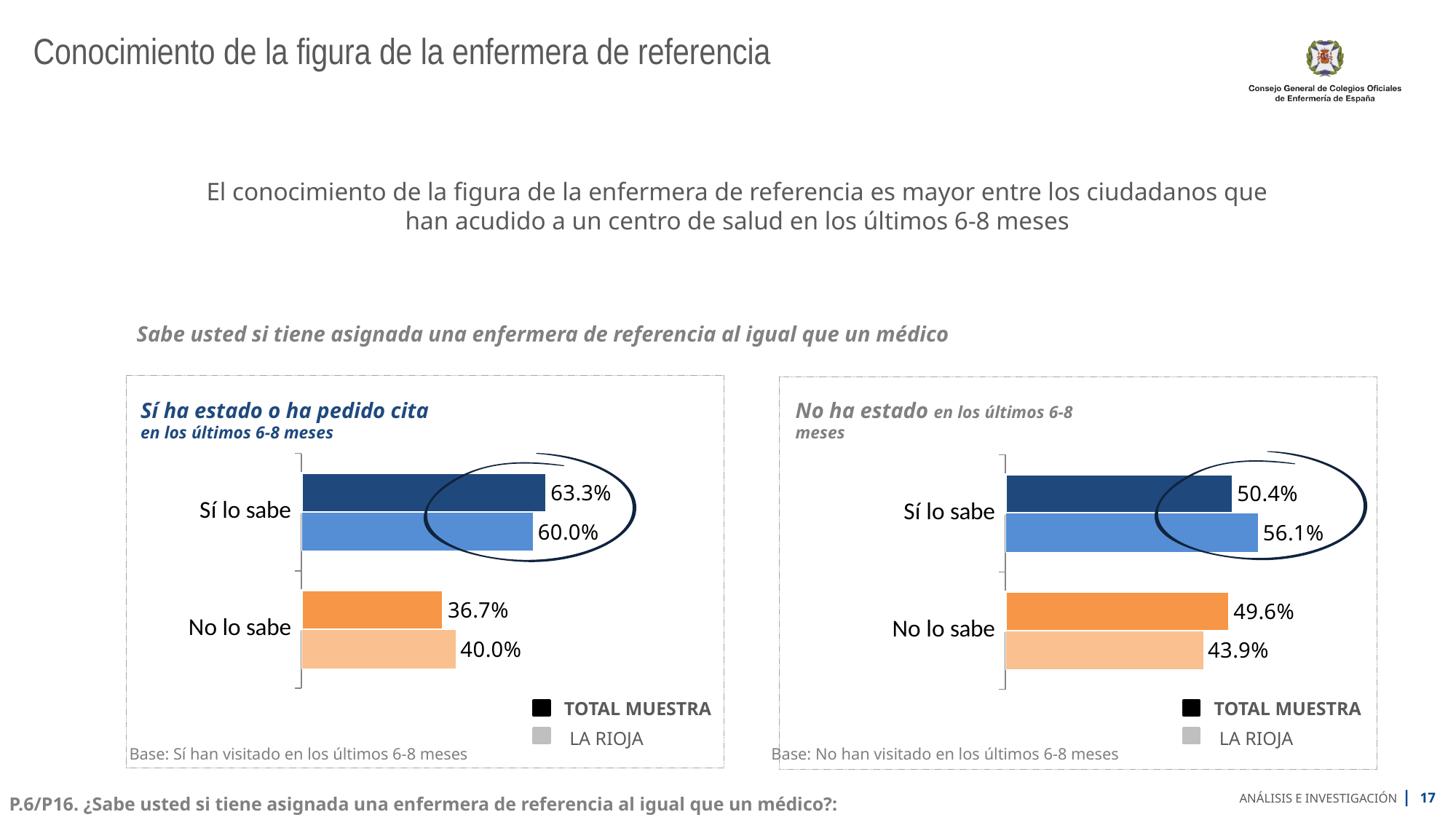
In the left chart (Sí ha estado o ha pedido cita en los últimos 6-8 meses), which bar has the highest value? Sí lo sabe, TOTAL MUESTRA (63.3%) What kind of chart is the right chart (No ha estado en los últimos 6-8 meses)? Bar chart In the left chart (Sí ha estado o ha pedido cita en los últimos 6-8 meses), what is the LA RIOJA value for 'No lo sabe'? 40.0% In the right chart (No ha estado en los últimos 6-8 meses), what is the TOTAL MUESTRA value for 'No lo sabe'? 49.6% In the right chart (No ha estado en los últimos 6-8 meses), which is larger for 'No lo sabe': TOTAL MUESTRA or LA RIOJA? TOTAL MUESTRA In the right chart (No ha estado en los últimos 6-8 meses), what is the difference between the LA RIOJA and TOTAL MUESTRA values for 'Sí lo sabe'? 5.7 percentage points In the left chart (Sí ha estado o ha pedido cita en los últimos 6-8 meses), what is the TOTAL MUESTRA value for 'Sí lo sabe'? 63.3% In the right chart (No ha estado en los últimos 6-8 meses), which bar has the lowest value? No lo sabe, LA RIOJA (43.9%) In the left chart (Sí ha estado o ha pedido cita en los últimos 6-8 meses), what is the difference between the TOTAL MUESTRA and LA RIOJA values for 'Sí lo sabe'? 3.3 percentage points How many series does the legend of the left chart list? 2 In the right chart (No ha estado en los últimos 6-8 meses), what is the LA RIOJA value for 'Sí lo sabe'? 56.1% In the left chart (Sí ha estado o ha pedido cita en los últimos 6-8 meses), which is larger for 'No lo sabe': TOTAL MUESTRA or LA RIOJA? LA RIOJA